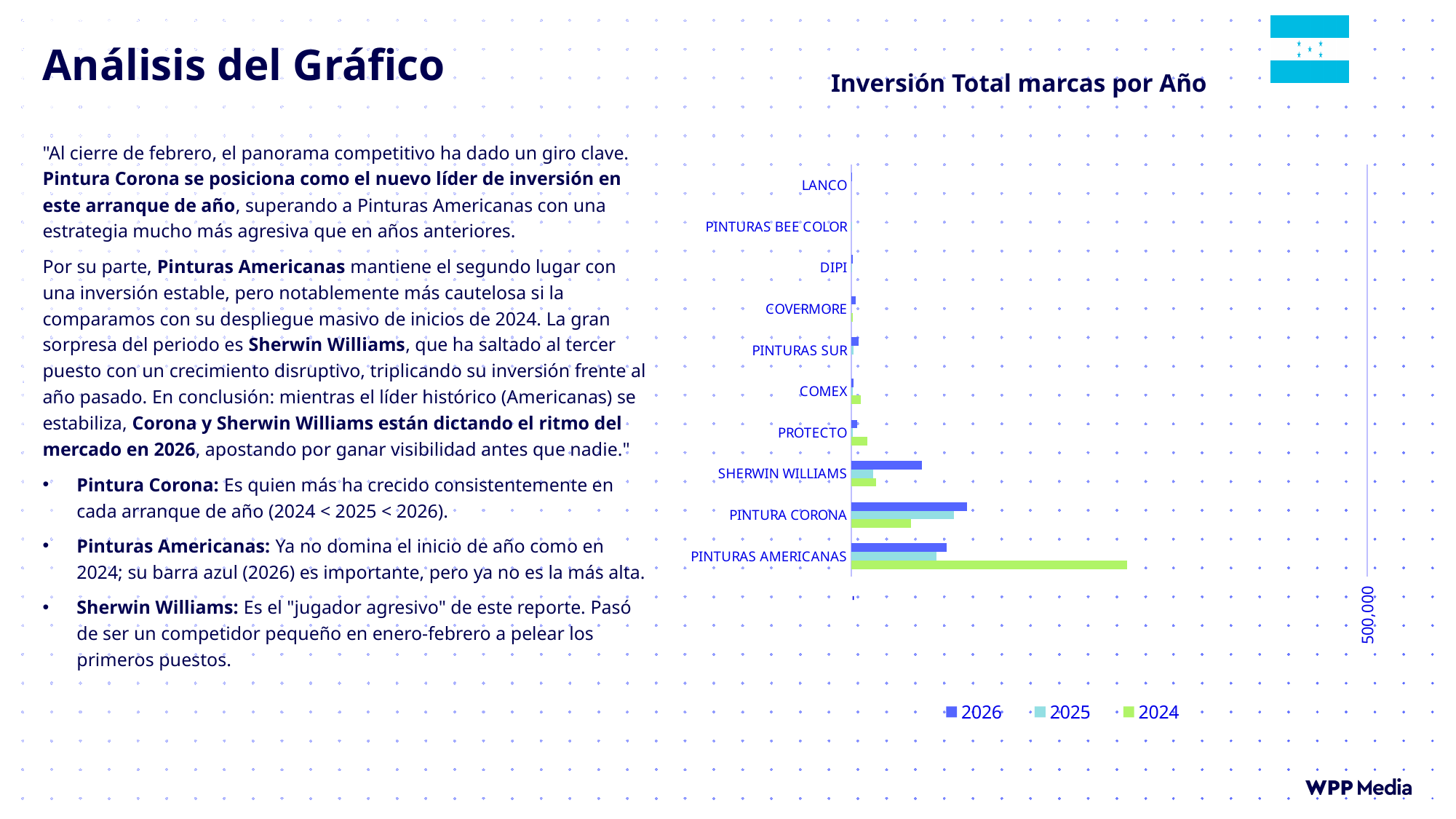
What kind of chart is shown on the slide? Bar chart For SHERWIN WILLIAMS, which is larger: the 2026 bar or the 2025 bar? 2026 How many brands (categories) are shown on the chart? 10 How many series does the chart legend list? 3 For PINTURAS AMERICANAS, which is larger: the 2024 bar or the 2026 bar? 2024 Which years are listed in the chart legend? 2026, 2025, 2024 Which brand has the longest bar overall on the chart? PINTURAS AMERICANAS Is the 2024 value for PINTURAS AMERICANAS greater or less than 500,000? less Which brand has the longest 2026 bar? PINTURA CORONA What is the title of the chart? Inversión Total marcas por Año Which brand has the longest 2024 bar? PINTURAS AMERICANAS Is the 2026 value for PINTURA CORONA greater or less than 500,000? less